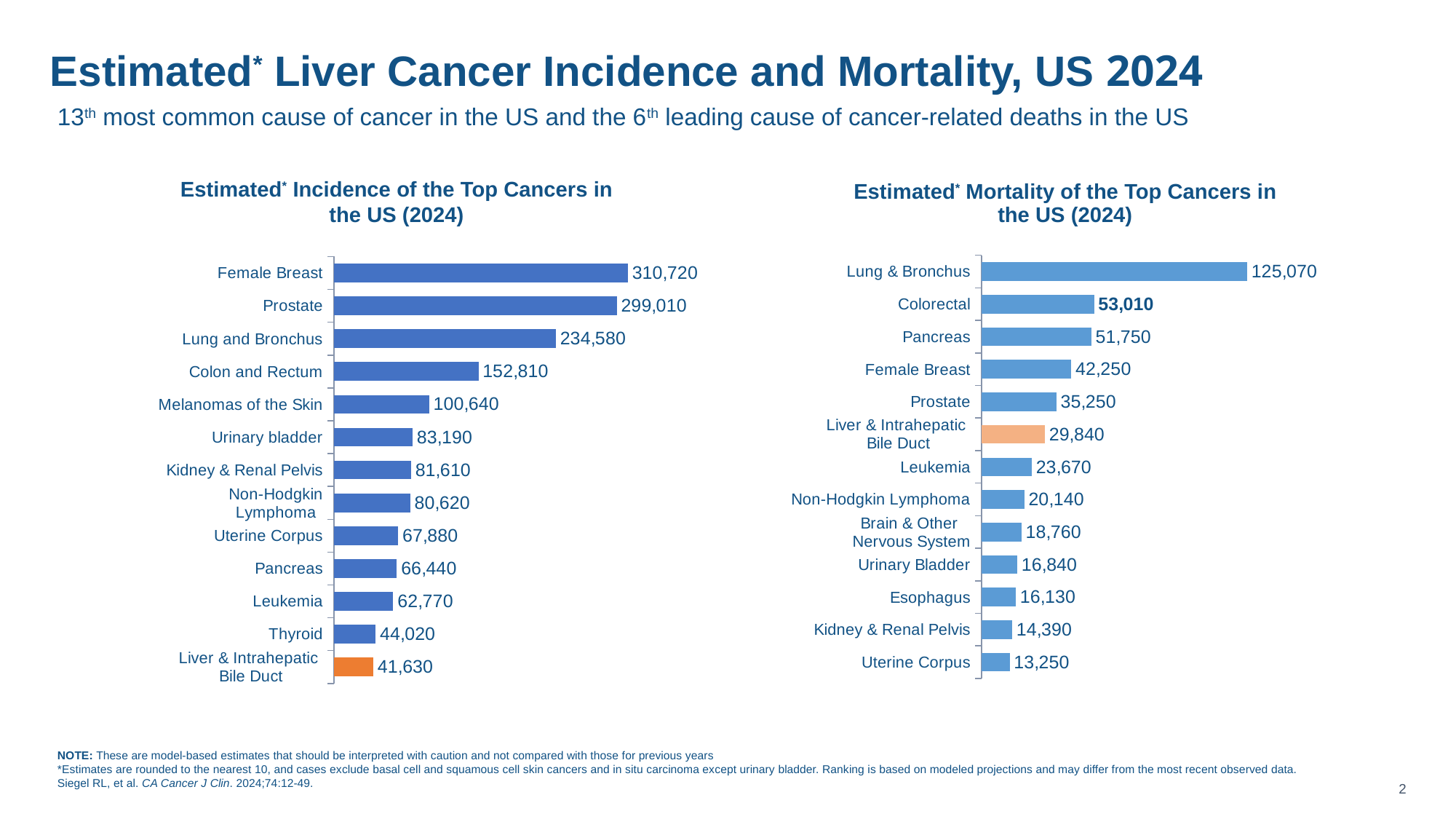
In the Estimated Mortality chart on the right, which category has the highest value? Lung & Bronchus What type of chart is the Estimated Incidence chart on the left? Bar chart In the Estimated Mortality chart on the right, what is the value for Pancreas? 51,750 In the Estimated Mortality of the Top Cancers in the US (2024) chart, what is the value for Liver & Intrahepatic Bile Duct? 29,840 In the Estimated Incidence chart on the left, which category has the lowest value? Liver & Intrahepatic Bile Duct In the Estimated Incidence chart on the left, what is the difference between Female Breast and Prostate? 11,710 In the Estimated Incidence chart on the left, which is larger: Thyroid or Leukemia? Leukemia How many categories are shown in the Estimated Mortality chart on the right? 13 In the Estimated Incidence chart on the left, what is the value for Liver & Intrahepatic Bile Duct? 41,630 In the Estimated Mortality chart on the right, what is the difference between Lung & Bronchus and Colorectal? 72,060 In the Estimated Mortality chart on the right, which category has the lowest value? Uterine Corpus In the Estimated Incidence of the Top Cancers in the US (2024) chart, what is the value for Female Breast? 310,720